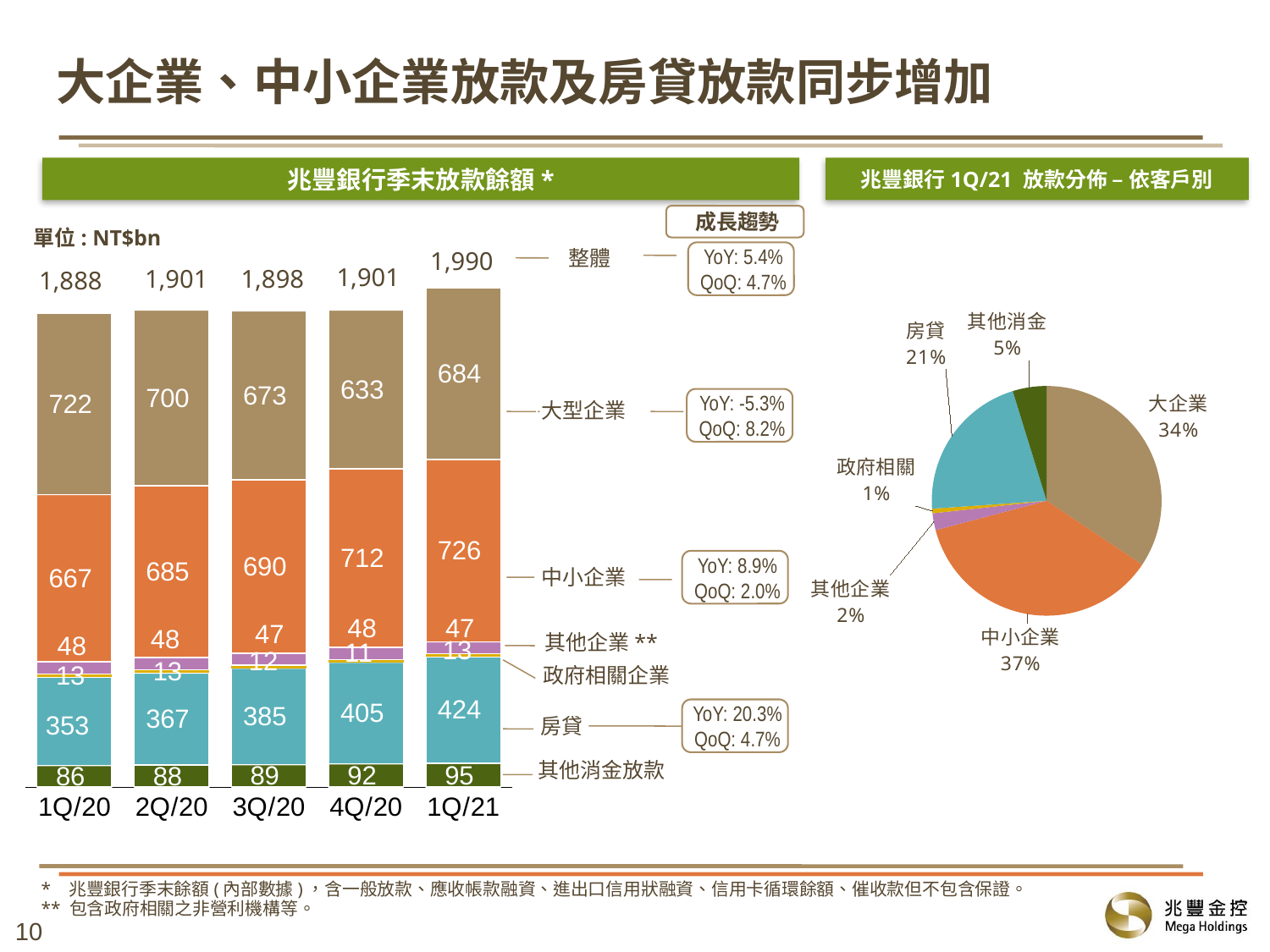
In the 兆豐銀行季末放款餘額 chart, which quarter has the highest total loan balance? 1Q/21 In the 兆豐銀行季末放款餘額 chart, how many quarters are shown on the x axis? 5 In the 兆豐銀行季末放款餘額 chart, what is the total loan balance for 1Q/21? 1,990 In the 兆豐銀行季末放款餘額 chart, which is larger in 1Q/21: 大型企業 or 中小企業? 中小企業 In the 兆豐銀行 1Q/21 放款分佈 pie chart, which category has the smallest share? 政府相關 In the 兆豐銀行 1Q/21 放款分佈 pie chart, what share does 中小企業 have? 37% What kind of chart is the 兆豐銀行季末放款餘額 chart? stacked bar chart In the 兆豐銀行季末放款餘額 chart, what is the 房貸 value for 1Q/21? 424 In the 兆豐銀行季末放款餘額 chart, which quarter has the lowest 大型企業 value? 4Q/20 In the 兆豐銀行季末放款餘額 chart, what is the difference between the 中小企業 values for 1Q/21 and 1Q/20? 59 In the 兆豐銀行季末放款餘額 chart, what is the 大型企業 value for 4Q/20? 633 In the 兆豐銀行季末放款餘額 chart, does the 房貸 value rise or fall from 1Q/20 to 1Q/21? rise